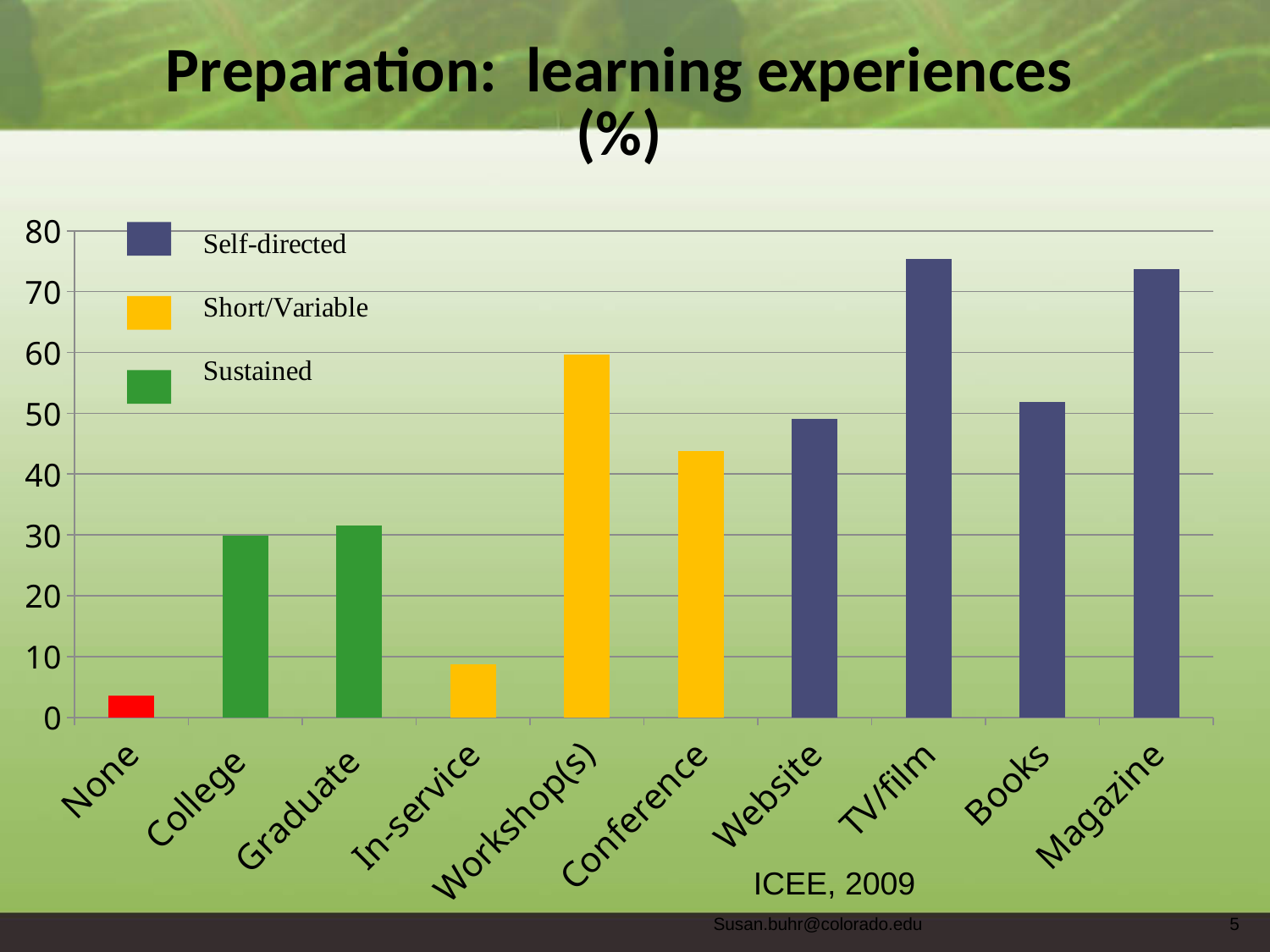
How many series does the chart's legend list? 3 Which is larger, the value for Workshop(s) or the value for Conference? Workshop(s) What kind of chart is shown on the slide? bar chart Is the value for TV/film greater or less than 70? greater Which category has the lowest value in the chart? None What is the title of the chart on the slide? Preparation: learning experiences (%) Is the value for Conference greater or less than 50? less Is the value for In-service greater or less than 10? less Which legend entry is shown in green? Sustained Which is larger, the value for Magazine or the value for Books? Magazine How many categories are shown along the x axis of the chart? 10